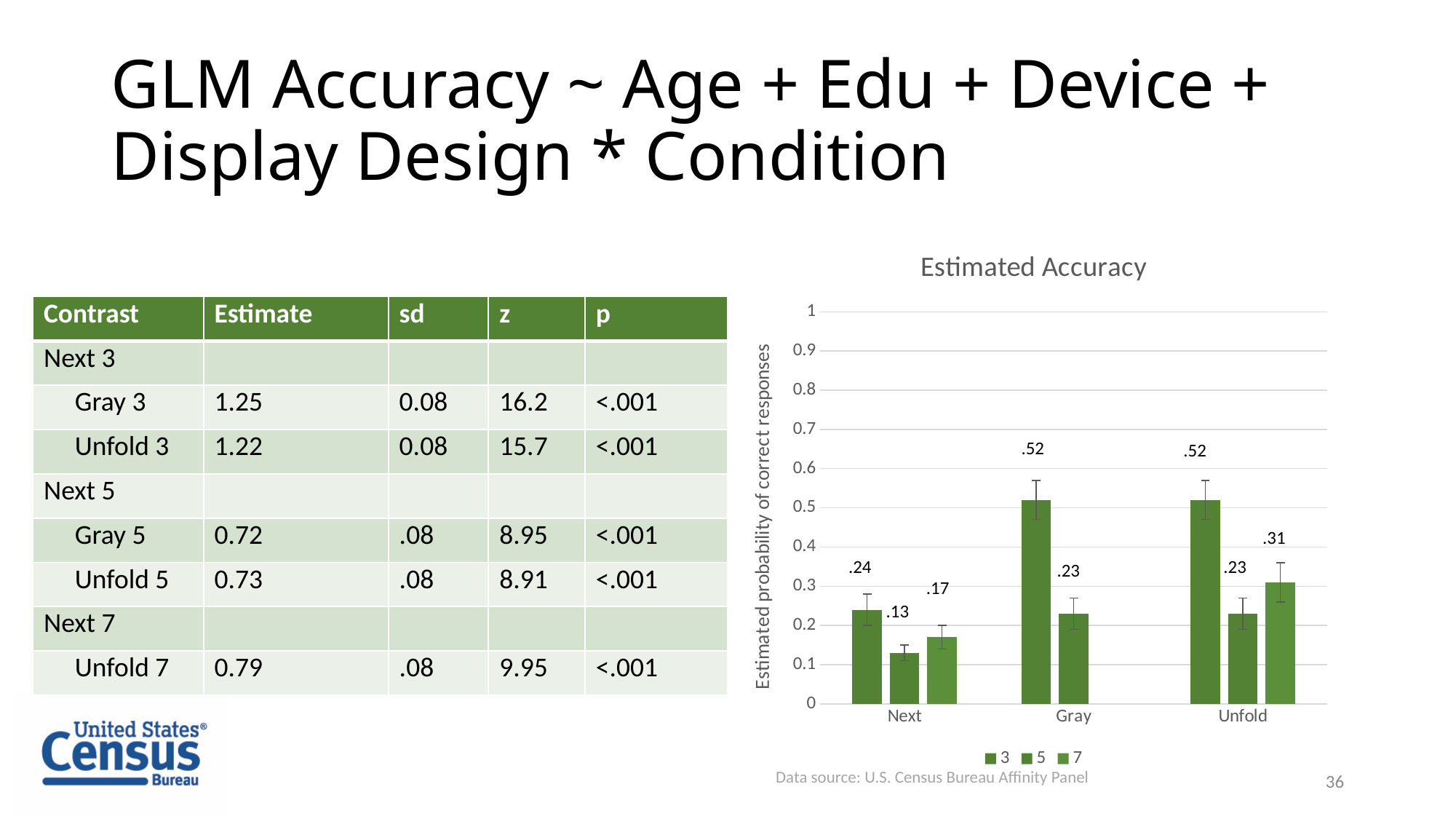
What is the difference between the series 3 value and the series 5 value in the Unfold category? .29 Which is larger: the series 7 value for Next or the series 7 value for Unfold? Unfold Which series has the highest value in the Unfold category? 3 What is the value for series 5 in the Next category? .13 How many categories are shown on the x axis of the chart? 3 What is the value for series 3 in the Next category? .24 How many series does the chart legend list? 3 What is the title of the chart? Estimated Accuracy What type of chart is shown on the slide? bar chart Which series has the lowest value in the Next category? 5 What is the value for series 3 in the Gray category? .52 What is the value for series 7 in the Unfold category? .31